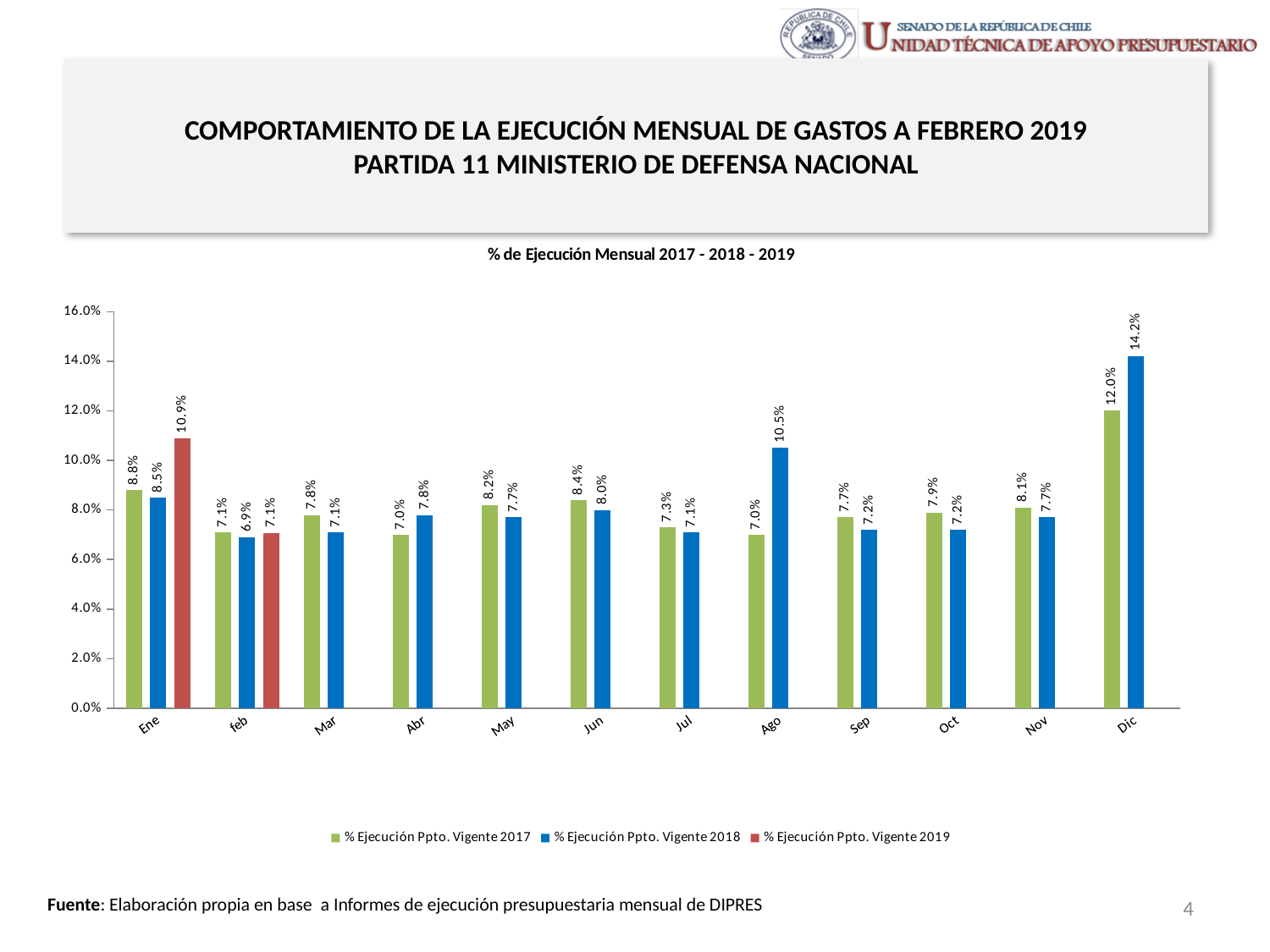
What is the value for % Ejecución Ppto. Vigente 2018 in Ago? 10.5% Is the value for % Ejecución Ppto. Vigente 2018 in Dic greater or less than 14.0%? greater In which month is the % Ejecución Ppto. Vigente 2018 series highest? Dic What is the difference between the 2018 and 2017 values in Dic? 2.2% Which is larger in Abr, the 2017 value or the 2018 value? 2018 What is the value for % Ejecución Ppto. Vigente 2019 in Ene? 10.9% What is the value for % Ejecución Ppto. Vigente 2017 in Dic? 12.0% How many months are shown on the x axis? 12 What is the title of the chart? % de Ejecución Mensual 2017 - 2018 - 2019 In which month is the % Ejecución Ppto. Vigente 2018 series lowest? feb How many series does the legend list? 3 What kind of chart is shown on the slide? Bar chart